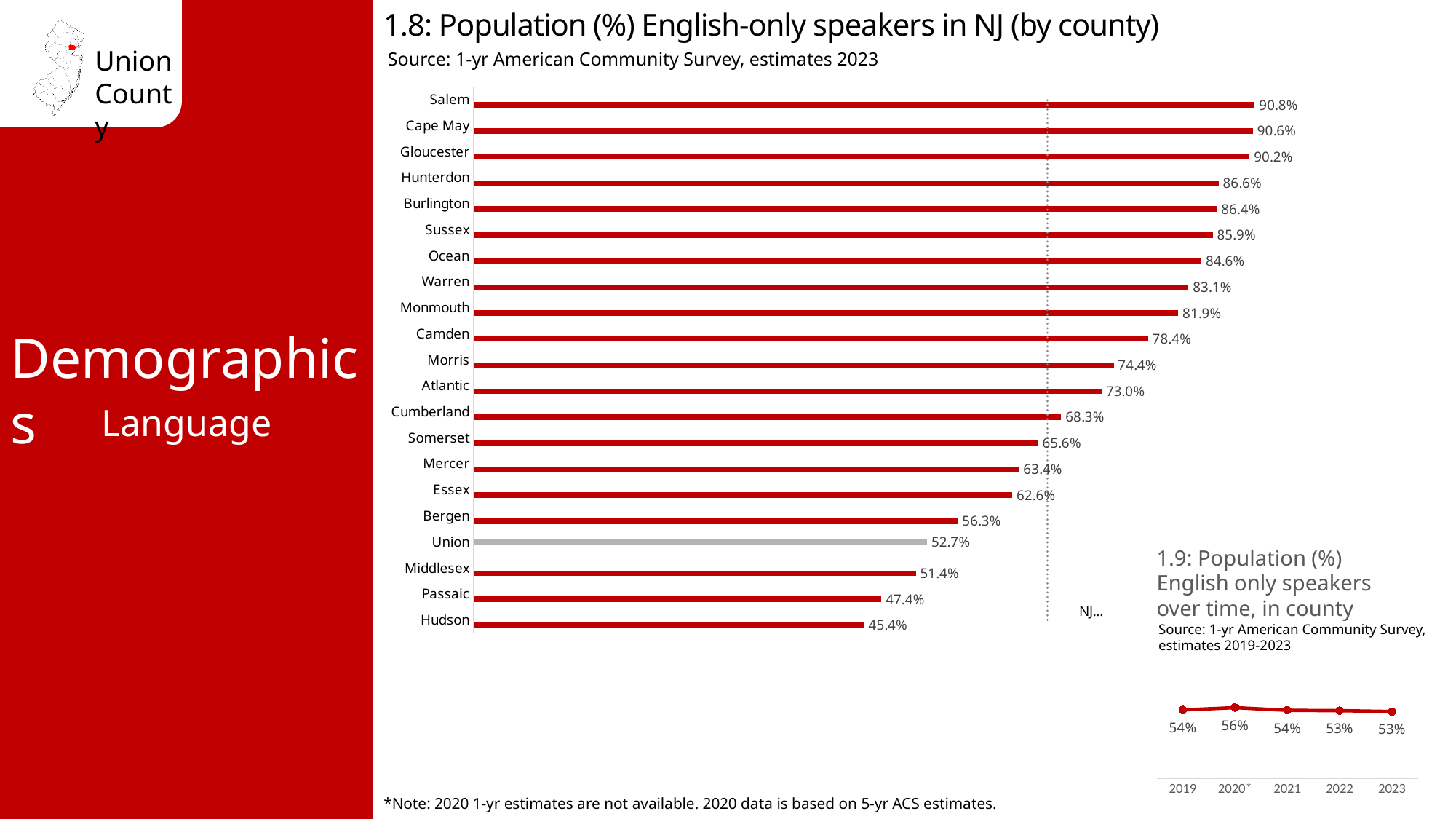
In chart 1.8, what is the difference between the values for Salem and Hudson? 45.4% In chart 1.8, what is the value for Bergen? 56.3% In chart 1.8, which county has the lowest percentage of English-only speakers? Hudson In chart 1.8, which county's bar is shown in grey instead of red? Union In chart 1.8, which has a higher value, Morris or Atlantic? Morris In chart 1.8, which county has the highest percentage of English-only speakers? Salem In chart 1.9, how many years are plotted? 5 In chart 1.9, what is the value for 2020? 56% In chart 1.9, do the values rise or fall from 2020 to 2023? Fall In chart 1.8, how many counties are shown? 21 In chart 1.8, what is the value for Union county? 52.7% What kind of chart is chart 1.8? Bar chart